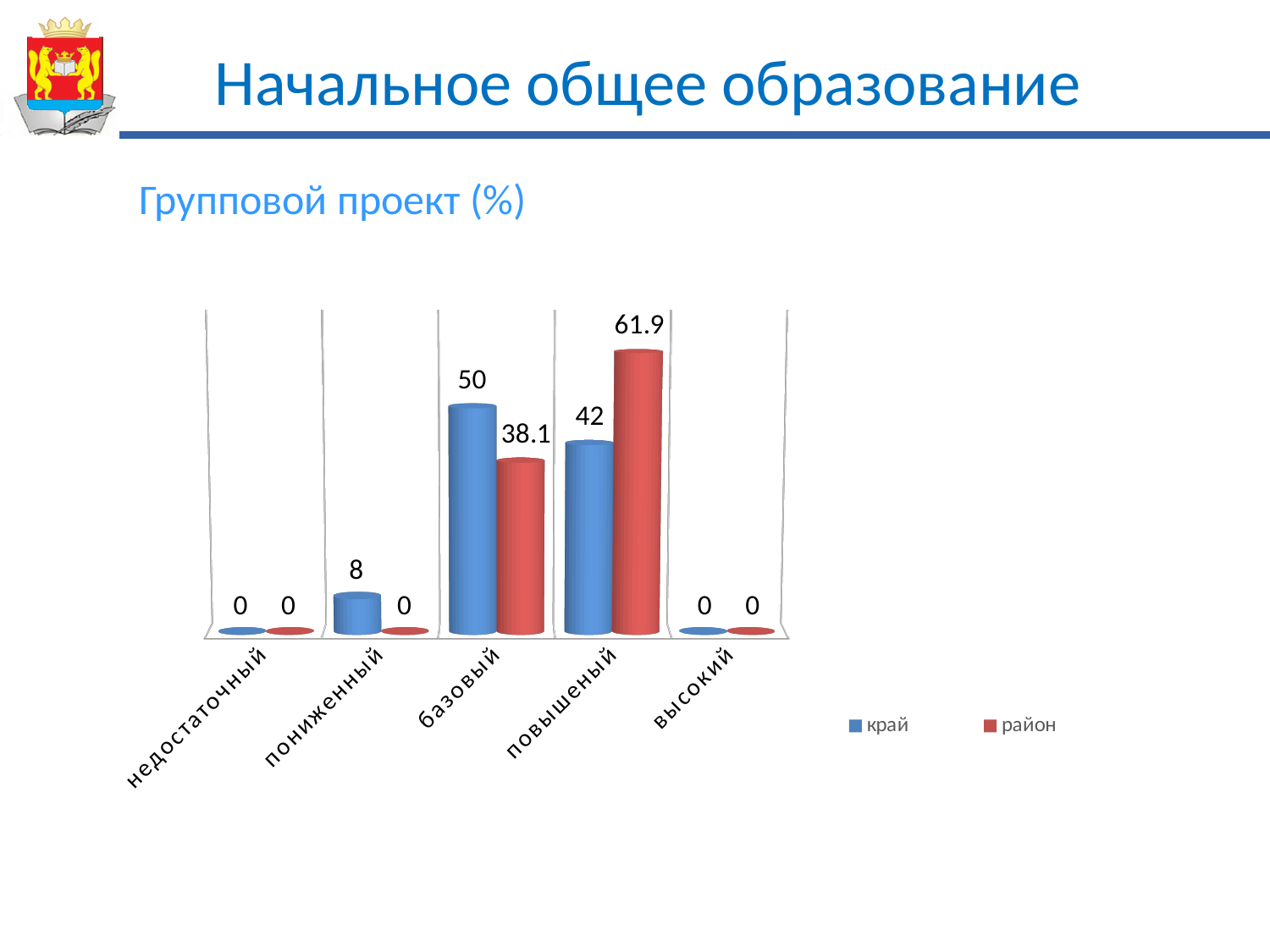
What is the difference between район and край in the повышеный category? 19.9 What is the value for район in the повышеный category? 61.9 Which category has the highest value for край? базовый Which category has the highest value for район? повышеный What is the value for край in the базовый category? 50 How many categories are shown on the x axis? 5 What is the value for край in the пониженный category? 8 How many series does the legend list? 2 What is the value for район in the базовый category? 38.1 What kind of chart is shown on the slide? bar chart What is the difference between край and район in the базовый category? 11.9 Which is larger in the базовый category, край or район? край